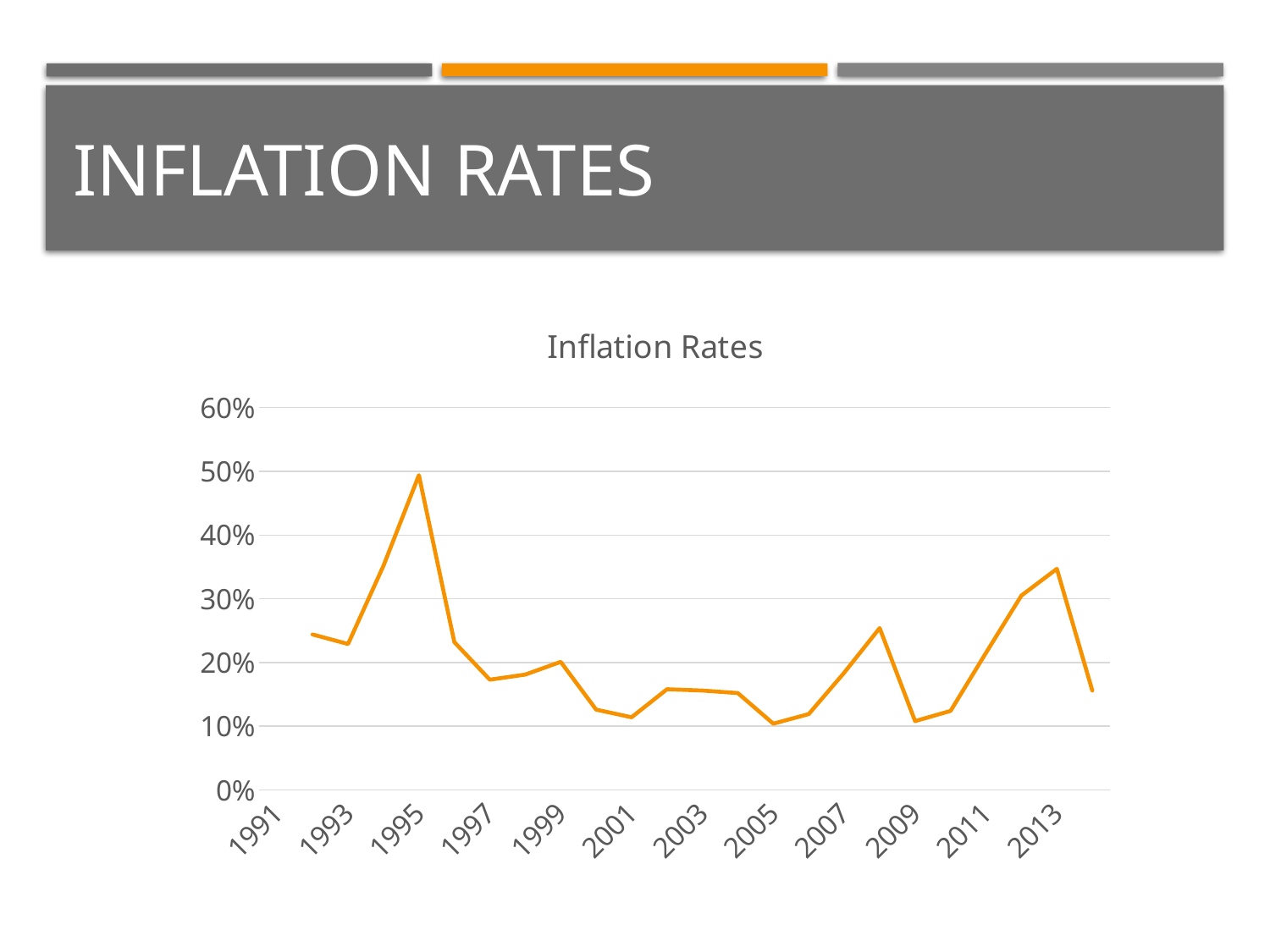
Is the inflation rate for 2013 greater or less than 20%? greater Is the inflation rate for 2000 greater or less than 20%? less What kind of chart is shown on the slide? line chart In which year does the inflation rate reach its highest value? 1995 How many year labels are shown on the x axis? 12 What is the title of the chart? Inflation Rates